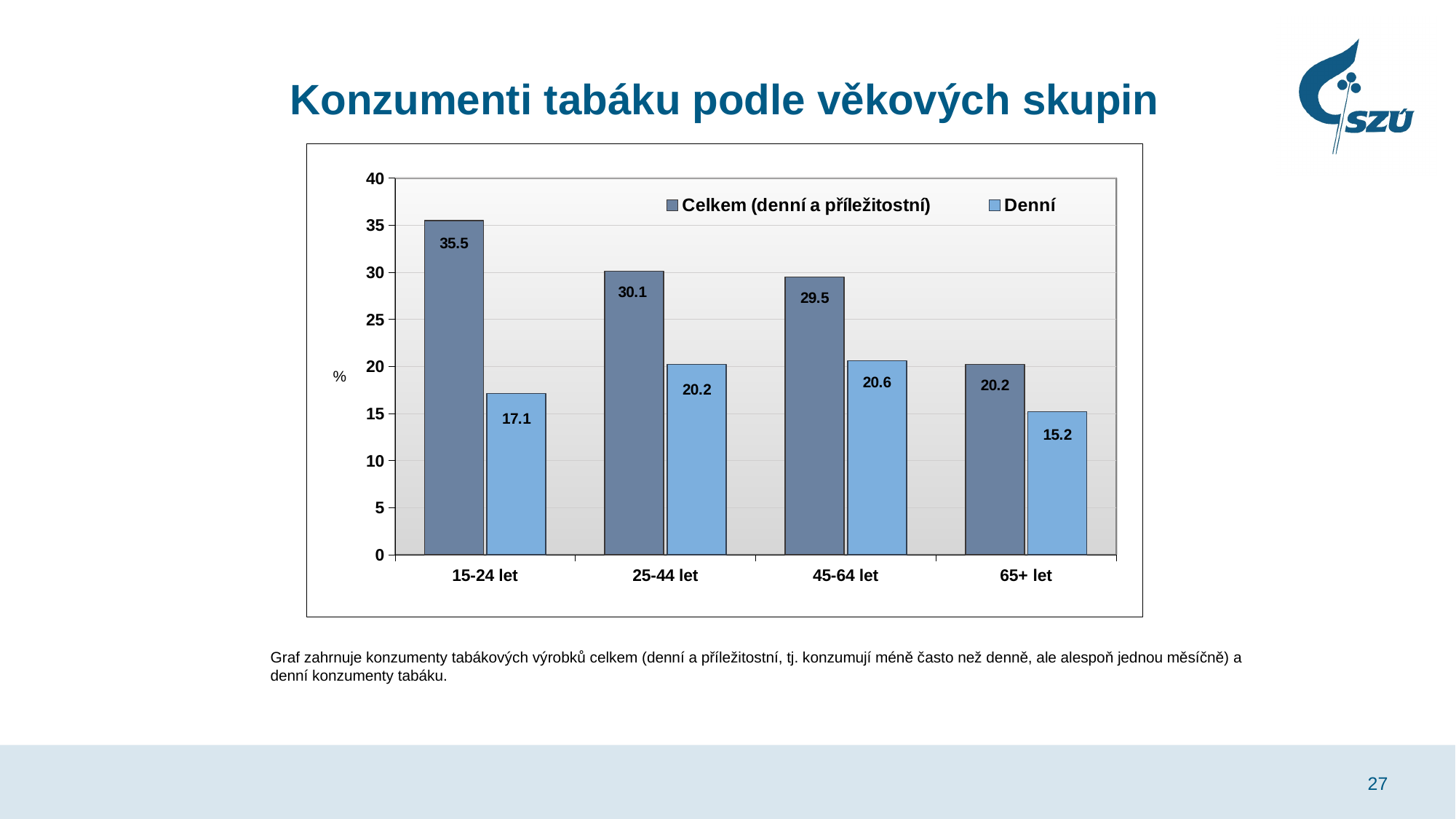
Is the 'Celkem (denní a příležitostní)' value for 45-64 let greater or less than 25? greater What is the value for 'Denní' in the 45-64 let age group? 20.6 Which age group has the highest value for 'Celkem (denní a příležitostní)'? 15-24 let How many series does the legend list? 2 How many age groups are shown on the x axis? 4 What is the title of the slide? Konzumenti tabáku podle věkových skupin Which is larger: the 'Denní' value for 25-44 let or the 'Denní' value for 65+ let? 25-44 let What kind of chart is shown on the slide? bar chart What is the difference between the 'Celkem (denní a příležitostní)' and 'Denní' values in the 15-24 let age group? 18.4 What is the value for 'Denní' in the 65+ let age group? 15.2 Which age group has the lowest value for 'Denní'? 65+ let What is the value for 'Celkem (denní a příležitostní)' in the 15-24 let age group? 35.5